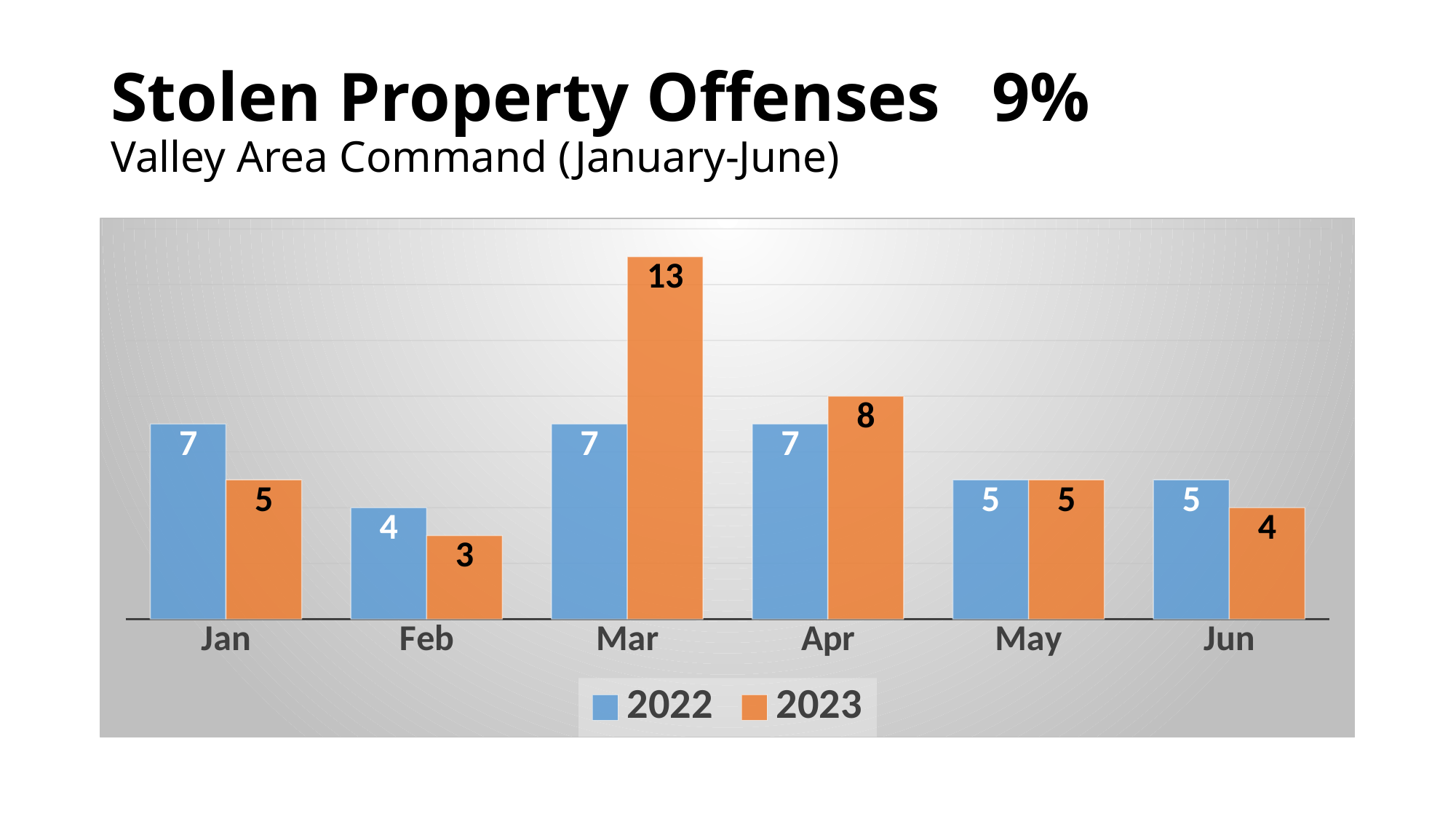
Which is larger in Apr, the 2022 value or the 2023 value? 2023 Which month has the highest value for 2023? Mar How many series does the legend list? 2 Which month has the lowest value for 2023? Feb What is the difference between the 2023 and 2022 values in Mar? 6 What is the value for 2023 in Jun? 4 What is the value for 2023 in Mar? 13 What is the value for 2022 in Feb? 4 What kind of chart is shown on the slide? Bar chart Which is larger in Jan, the 2022 value or the 2023 value? 2022 What is the title of the chart? Stolen Property Offenses How many months are shown on the x axis? 6